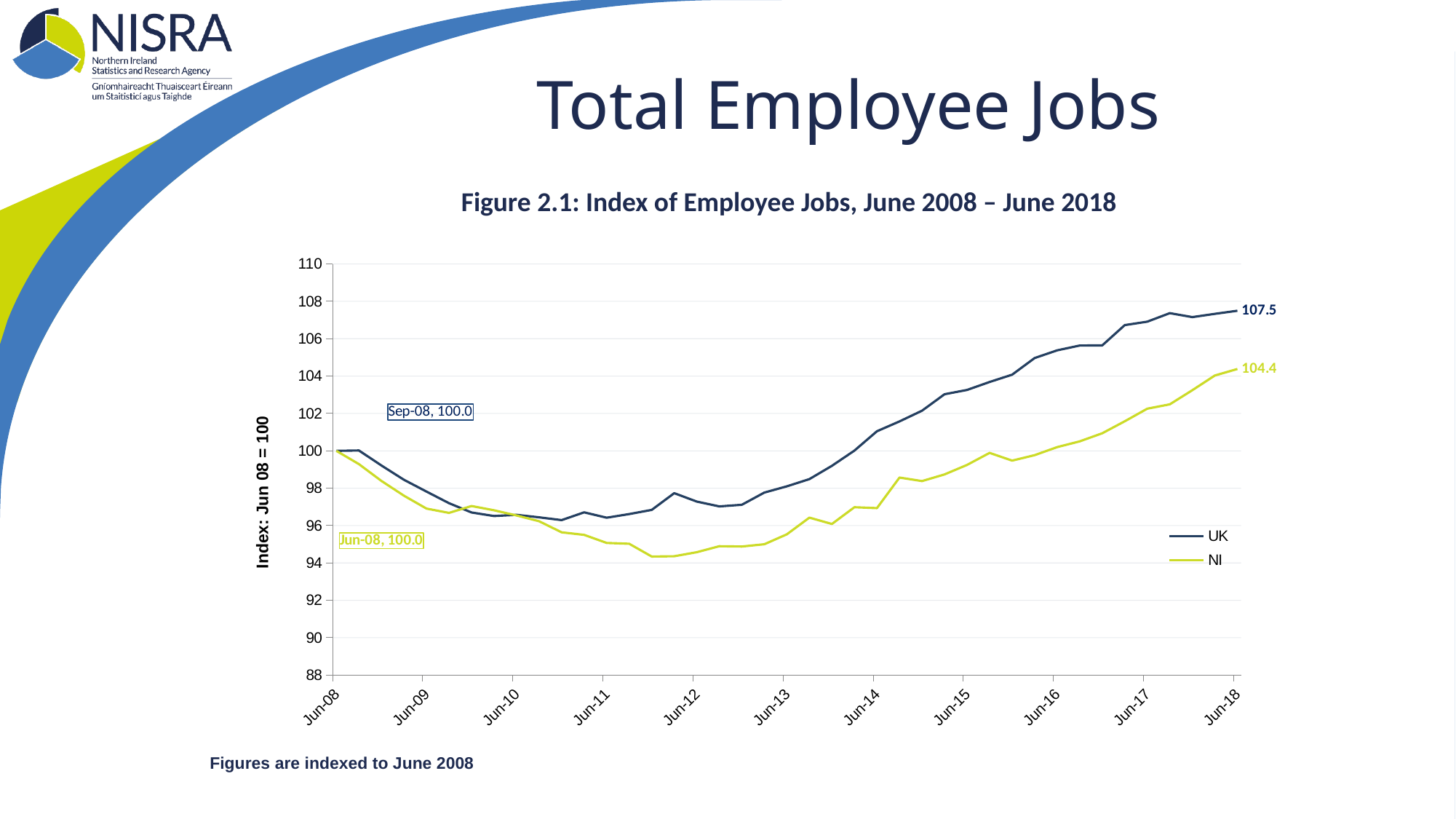
What is the UK index value at Jun-18 in Figure 2.1? 107.5 Is the NI index value at Jun-12 greater or less than 96? less Which series has the higher index value at Jun-18, UK or NI? UK What is the difference between the UK and NI index values at Jun-18? 3.1 What is the title of the chart on the slide? Figure 2.1: Index of Employee Jobs, June 2008 – June 2018 What is the NI index value labelled at Jun-08? 100.0 How many series does the legend list in Figure 2.1? 2 Between Jun-13 and Jun-18, does the UK index rise or fall? rise What is the NI index value at Jun-18 in Figure 2.1? 104.4 What type of chart is shown in Figure 2.1? line chart Is the UK index value at Jun-16 greater or less than 104? greater What is the UK index value labelled at Sep-08? 100.0